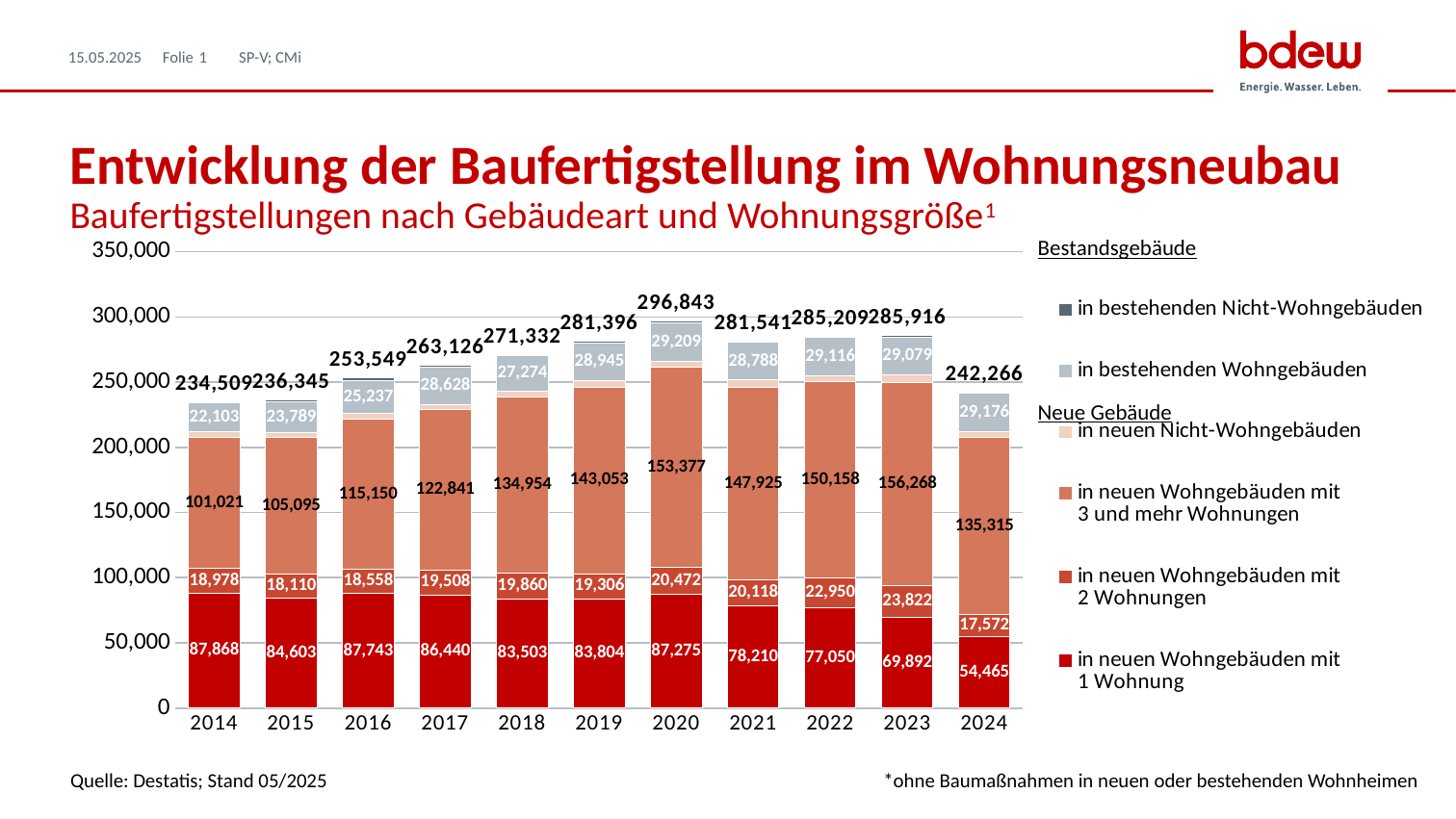
What is the value for 'in neuen Wohngebäuden mit 1 Wohnung' in 2024? 54,465 How many years are shown on the x axis? 11 What is the value for 'in neuen Wohngebäuden mit 3 und mehr Wohnungen' in 2023? 156,268 What is the value for 'in bestehenden Wohngebäuden' in 2016? 25,237 Which year has the lowest total of Baufertigstellungen? 2014 Which is larger: the value for 'in neuen Wohngebäuden mit 1 Wohnung' in 2014 or in 2023? 2014 What kind of chart is shown on the slide? Stacked bar chart Does the value for 'in neuen Wohngebäuden mit 1 Wohnung' rise or fall from 2020 to 2024? Fall How many series does the legend list? 6 What is the total number of Baufertigstellungen shown for 2020? 296,843 Which year has the highest total of Baufertigstellungen? 2020 What is the difference between the total for 2020 and the total for 2019? 15,447